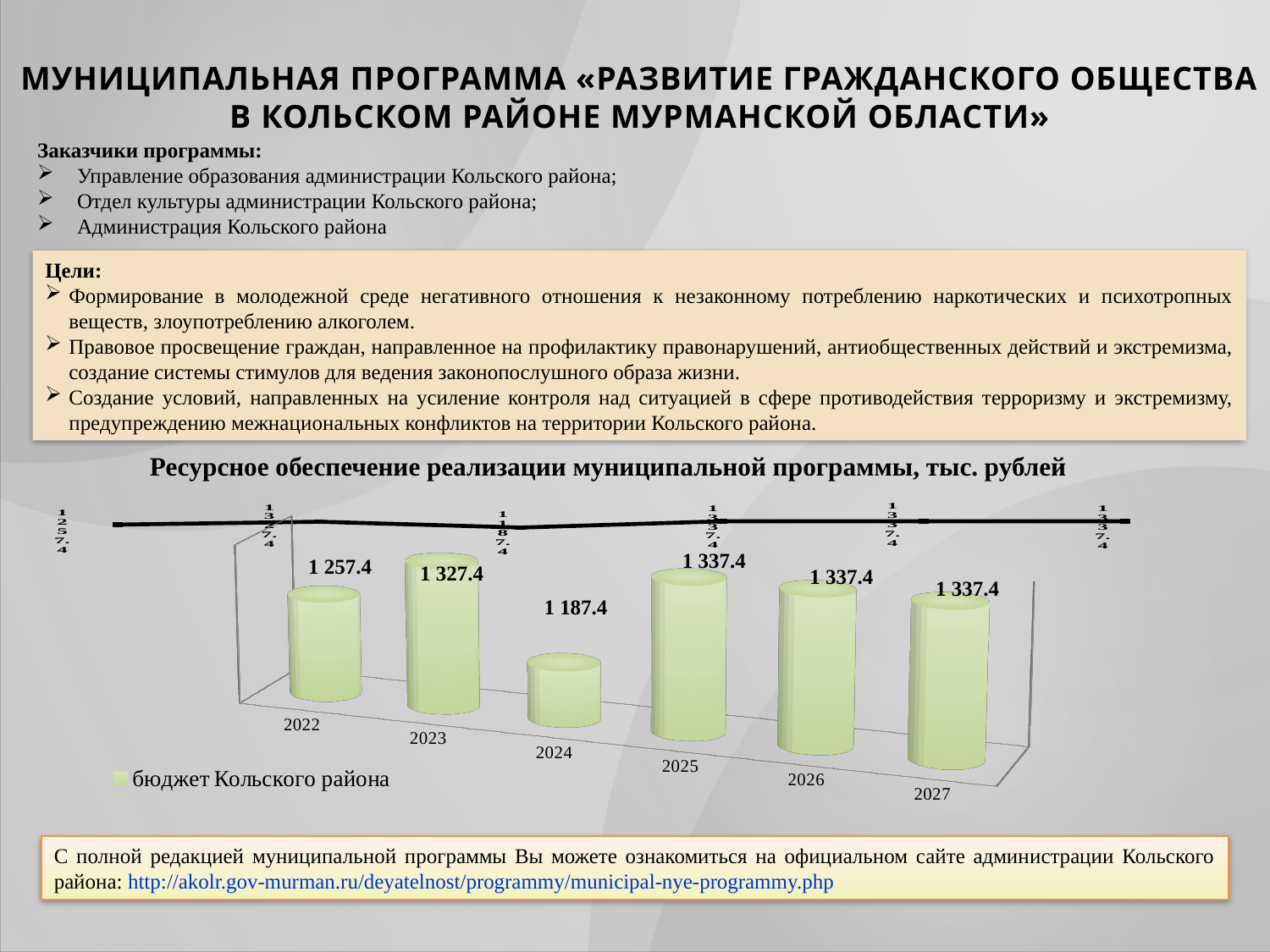
What is the difference between the values for 2025 and 2024? 150 Which year has the lowest value in the chart? 2024 How many years are shown on the x axis of the chart? 6 What is the value for 2023 in the chart? 1 327.4 What is the value for 2027 in the chart? 1 337.4 What is the difference between the values for 2023 and 2022? 70 How many entries does the chart legend list? 1 Which is larger, the value for 2023 or the value for 2024? 2023 What kind of chart is shown on the slide? bar chart What is the title of the chart? Ресурсное обеспечение реализации муниципальной программы, тыс. рублей What is the value for 2022 in the chart? 1 257.4 What is the value for 2024 in the chart? 1 187.4